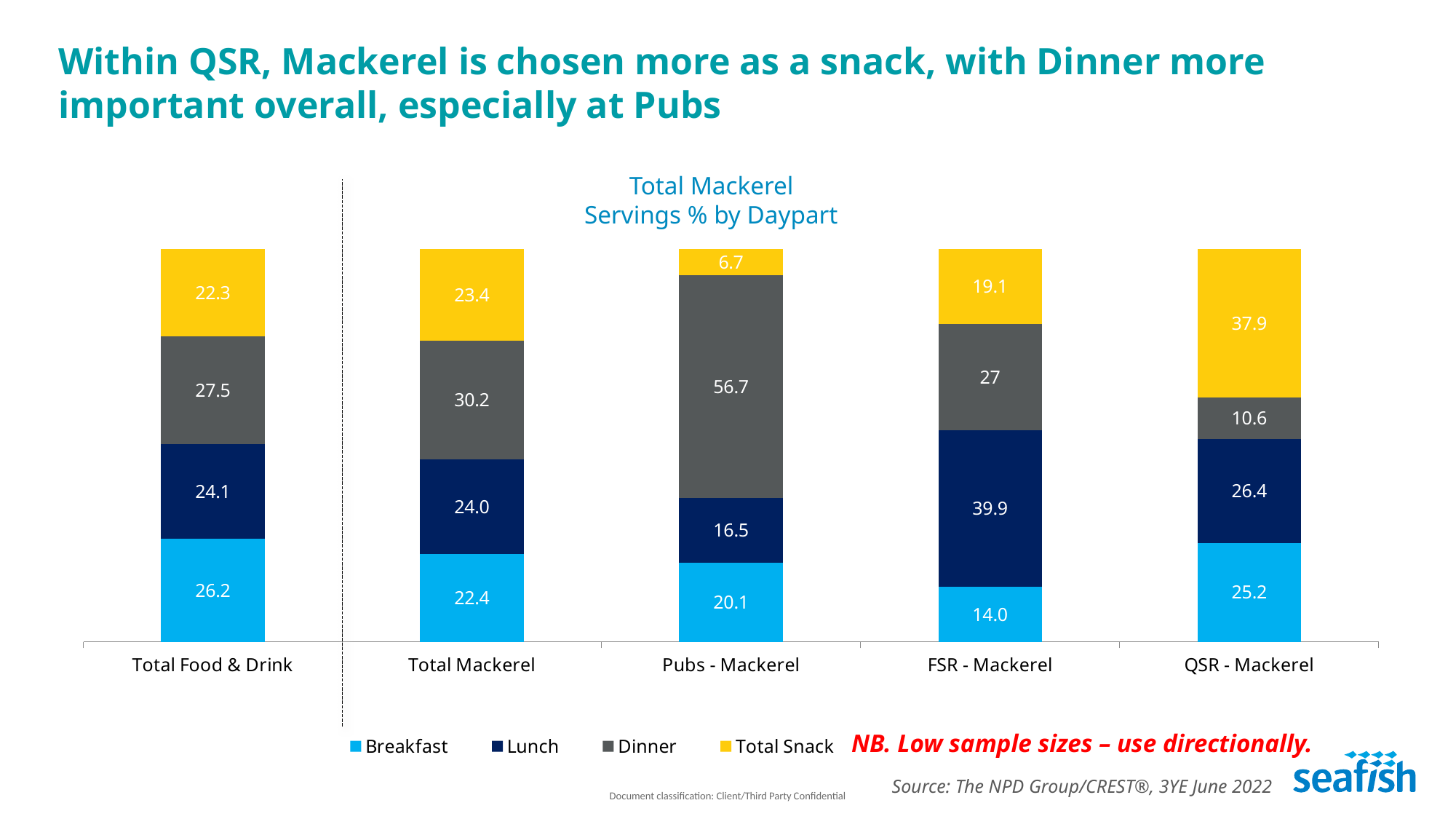
How many categories are shown on the x axis? 5 What kind of chart is shown on the slide? Stacked bar chart Which category has the lowest Breakfast value? FSR - Mackerel What is the Total Snack value for QSR - Mackerel? 37.9 Which category has the highest Dinner value? Pubs - Mackerel What is the total of the stacked bar for Pubs - Mackerel? 100.0 How many series does the legend list? 4 What is the Lunch value for FSR - Mackerel? 39.9 Which is larger: the Total Snack value for QSR - Mackerel or for Pubs - Mackerel? QSR - Mackerel What is the difference between the Dinner values for Pubs - Mackerel and QSR - Mackerel? 46.1 What is the Dinner value for Pubs - Mackerel? 56.7 What is the Breakfast value for Total Food & Drink? 26.2